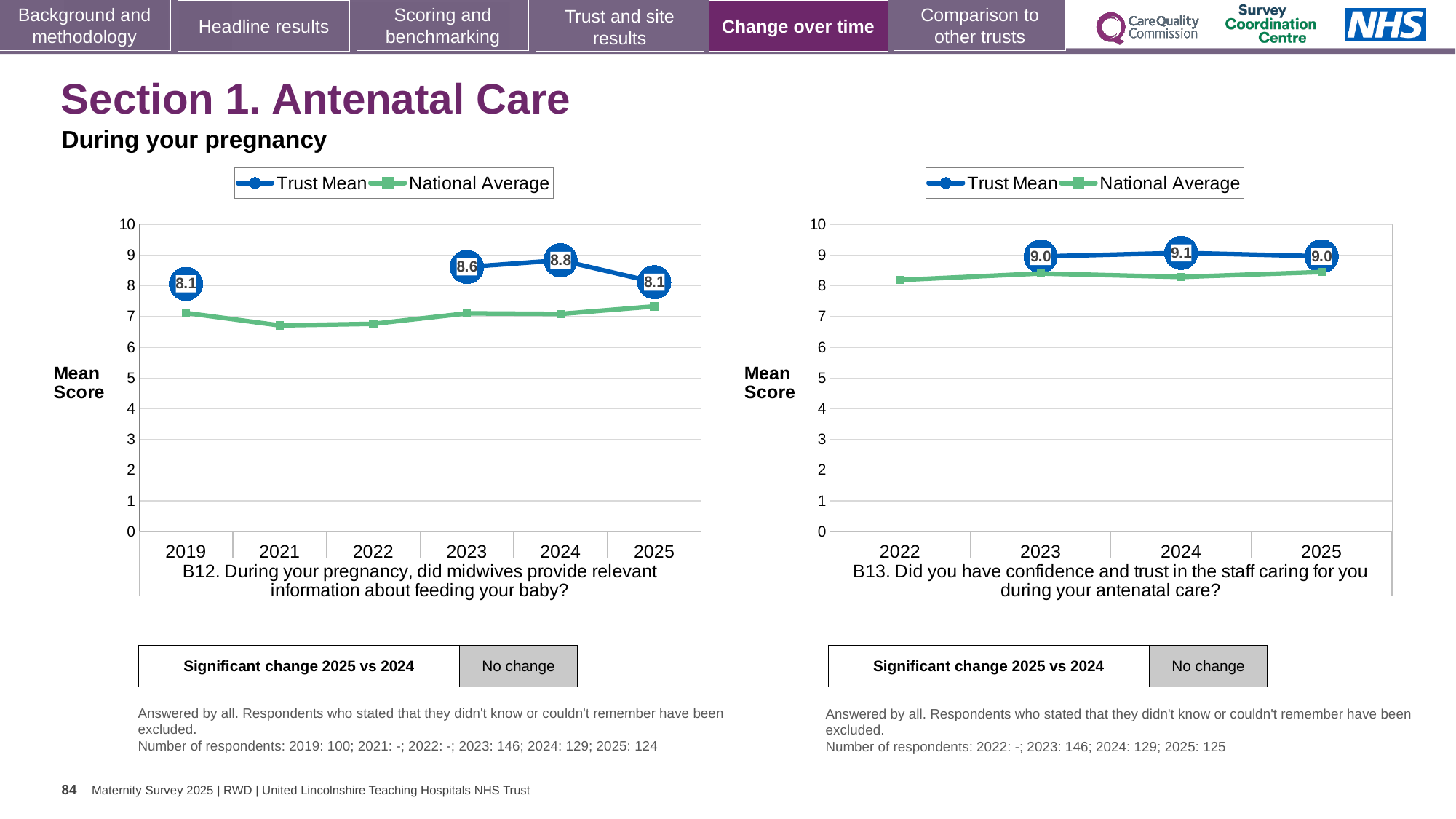
In the B12 chart (left), what is the Trust Mean for 2025? 8.1 How many years are shown on the x axis of the B13 chart (right)? 4 In the B13 chart (right), what is the difference between the Trust Mean in 2024 and in 2023? 0.1 What type of chart is the B13 chart (right)? line chart In the B13 chart (right), what is the Trust Mean for 2024? 9.1 How many series does the legend of the B12 chart (left) list? 2 In the B13 chart (right), is the National Average for 2022 greater or less than 8? greater In the B12 chart (left), what is the Trust Mean for 2024? 8.8 In the B12 chart (left), is the National Average for 2021 greater or less than 7? less In the B12 chart (left), which year has the highest Trust Mean? 2024 In the B12 chart (left), what is the difference between the Trust Mean in 2024 and in 2025? 0.7 In the B12 chart (left), is the Trust Mean for 2023 higher or lower than the Trust Mean for 2019? higher